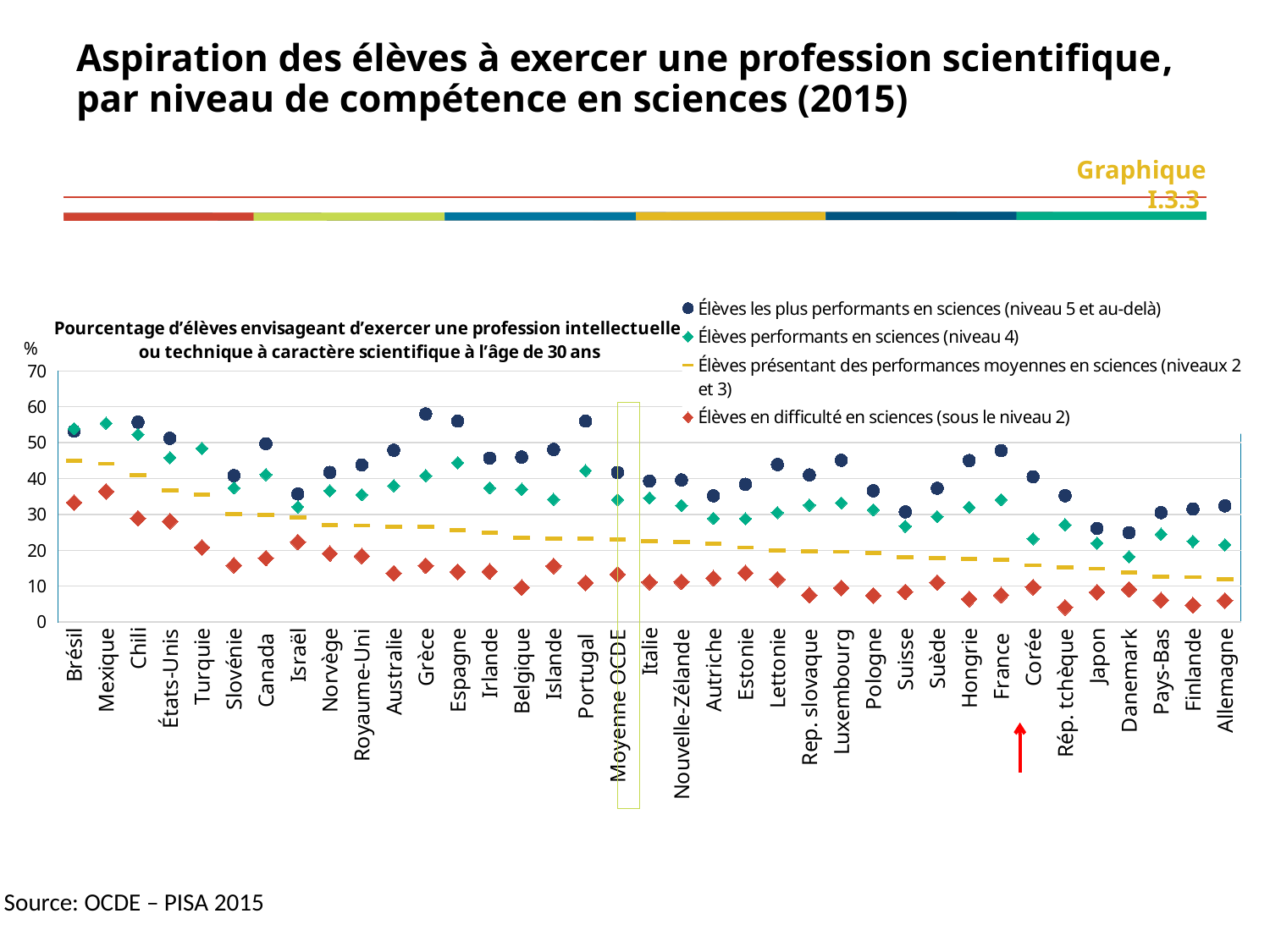
Which has the larger value in the series 'Élèves en difficulté en sciences (sous le niveau 2)': Brésil or Rép. tchèque? Brésil What kind of chart is shown on the slide? scatter chart Which has the larger value in the series 'Élèves les plus performants en sciences (niveau 5 et au-delà)': Grèce or Corée? Grèce Which country on the x axis is marked with a red arrow below the chart? France How many countries/categories are plotted along the x axis (including Moyenne OCDE)? 37 Is the value for Brésil in the series 'Élèves en difficulté en sciences (sous le niveau 2)' greater or less than 30? greater Is the value for Rép. tchèque in the series 'Élèves en difficulté en sciences (sous le niveau 2)' greater or less than 10? less Is the value for Grèce in the series 'Élèves les plus performants en sciences (niveau 5 et au-delà)' greater or less than 50? greater Do the values of the dashed series 'Élèves présentant des performances moyennes en sciences (niveaux 2 et 3)' generally rise or fall from left to right along the x axis? fall How many series does the legend list? 4